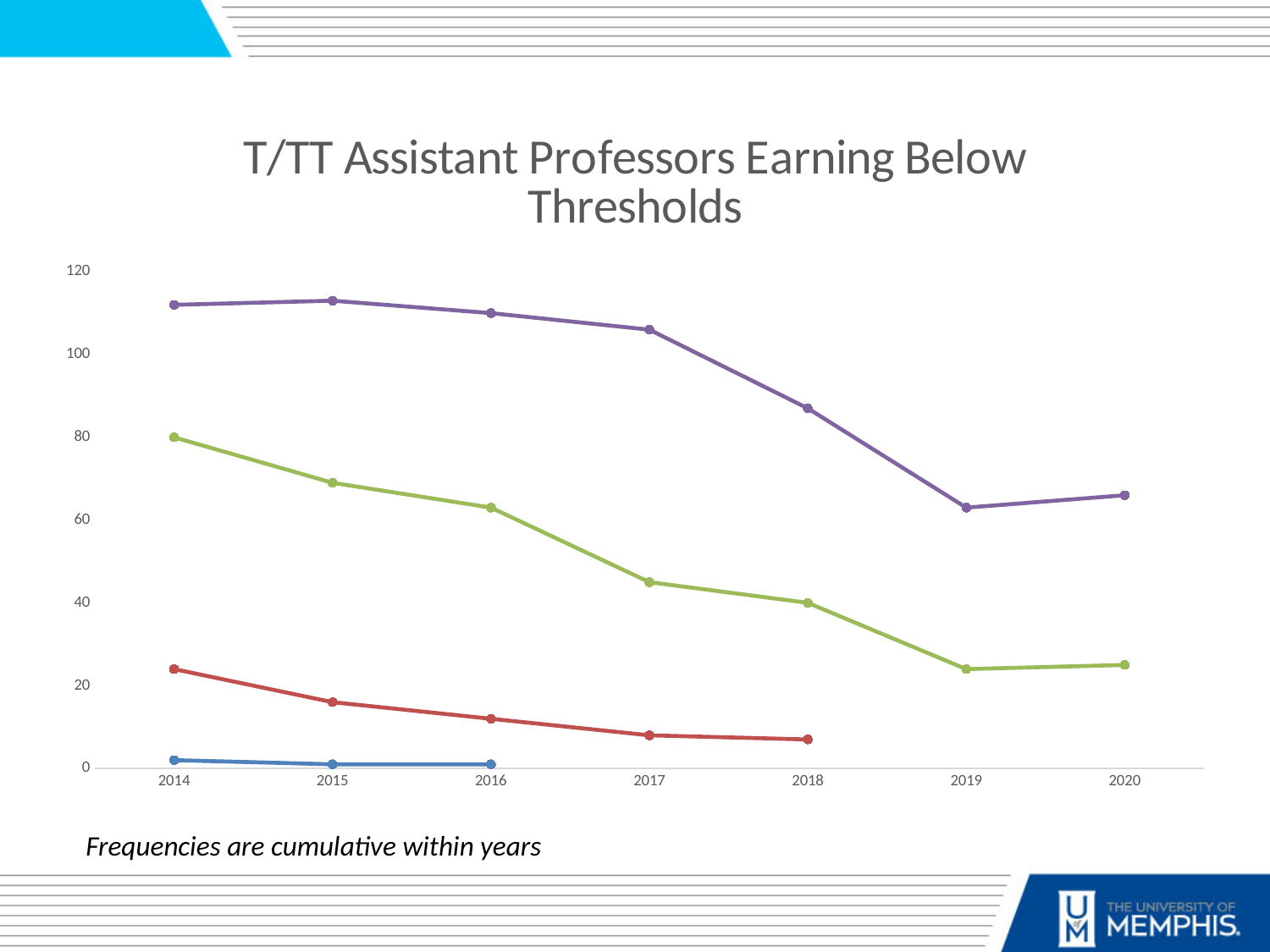
Does the purple line rise or fall overall from 2014 to 2020? fall How many lines are plotted on the chart? 4 What kind of chart is shown on the slide? line chart Is the value of the green line in 2019 greater or less than 40? less Is the value of the red line in 2018 greater or less than 20? less Is the value of the purple line in 2014 greater or less than 100? greater Does the green line rise or fall overall from 2014 to 2020? fall How many years are shown on the x axis of the chart? 7 Which line has the lowest values on the chart? blue line What is the title of the chart? T/TT Assistant Professors Earning Below Thresholds In 2017, which line has the larger value, the purple line or the green line? purple line